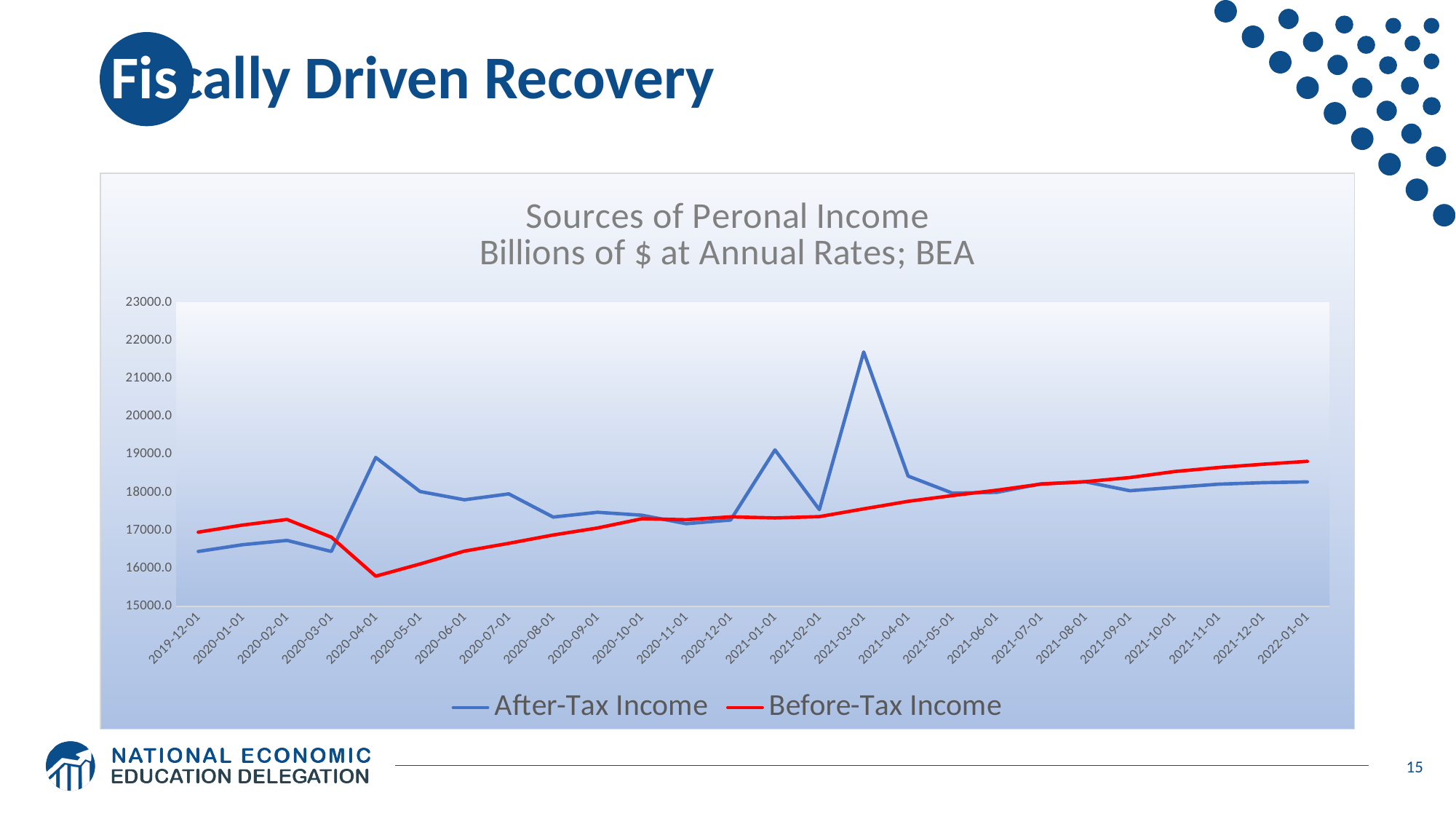
Does Before-Tax Income rise or fall from 2020-04-01 to 2022-01-01? rise How many series does the legend list? 2 At 2021-03-01, which series has the larger value, After-Tax Income or Before-Tax Income? After-Tax Income Is the value for After-Tax Income at 2021-03-01 greater or less than 21000.0? greater At which date does After-Tax Income reach its highest value? 2021-03-01 Is the value for After-Tax Income at 2021-01-01 greater or less than 18000.0? greater At 2022-01-01, which series has the larger value, After-Tax Income or Before-Tax Income? Before-Tax Income What colour is the line for Before-Tax Income? red Is the value for Before-Tax Income at 2020-04-01 greater or less than 16000.0? less How many dates are labelled along the x axis? 26 What kind of chart is shown on the slide? line chart At which date does Before-Tax Income reach its lowest value? 2020-04-01